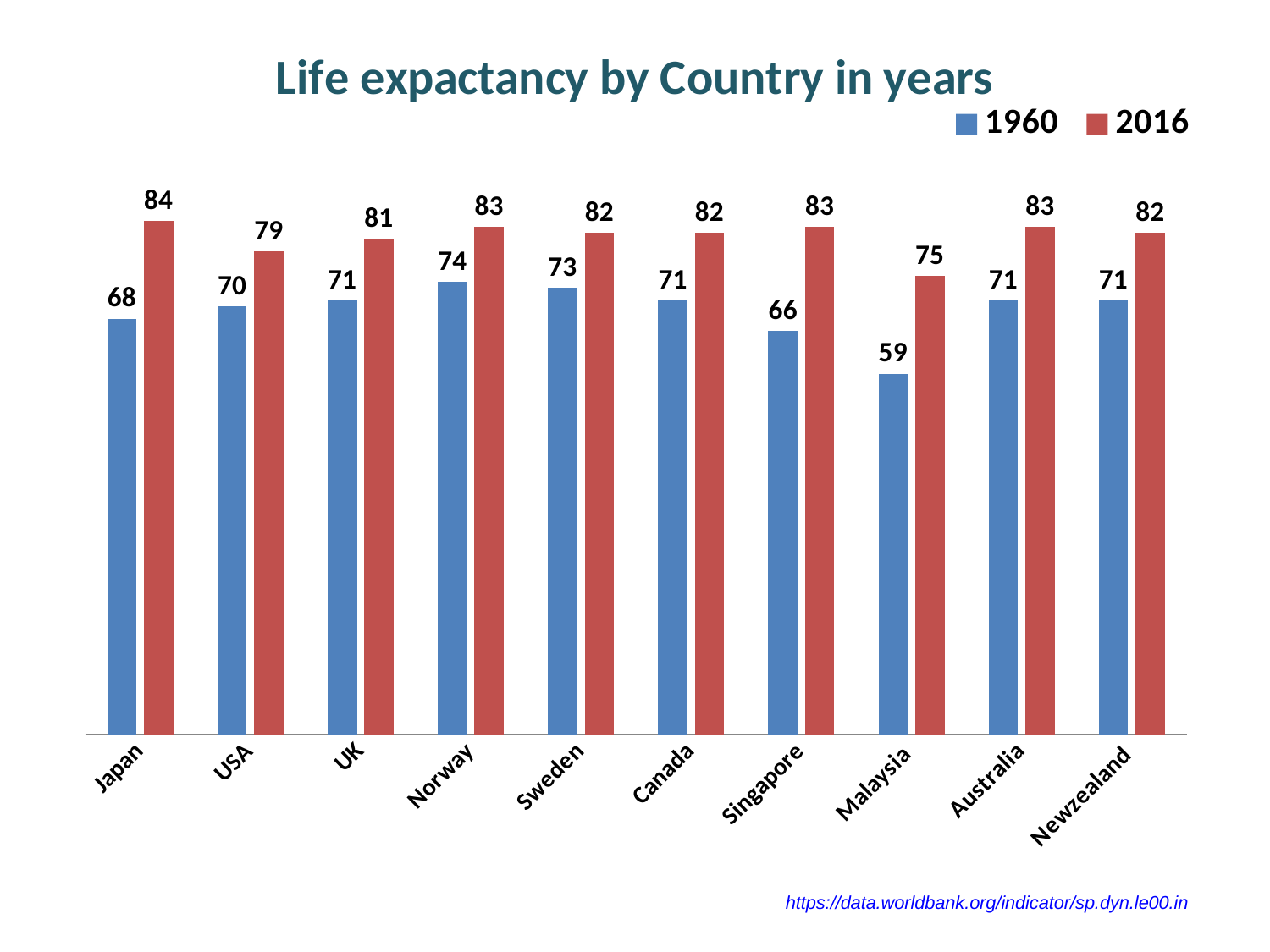
What was the life expectancy in Norway in 1960? 74 What is the difference between the 2016 life expectancy of Japan and the USA? 5 Which had a higher life expectancy in 1960, Norway or Singapore? Norway How many countries are shown in the chart? 10 By how many years did life expectancy in Malaysia increase from 1960 to 2016? 16 What type of chart is shown on the slide? Bar chart Which country had the highest life expectancy in 2016? Japan What was the life expectancy in Malaysia in 1960? 59 Which country had the lowest life expectancy in 1960? Malaysia How many series does the legend list? 2 What is the title of the chart? Life expactancy by Country in years What was the life expectancy in Japan in 2016? 84